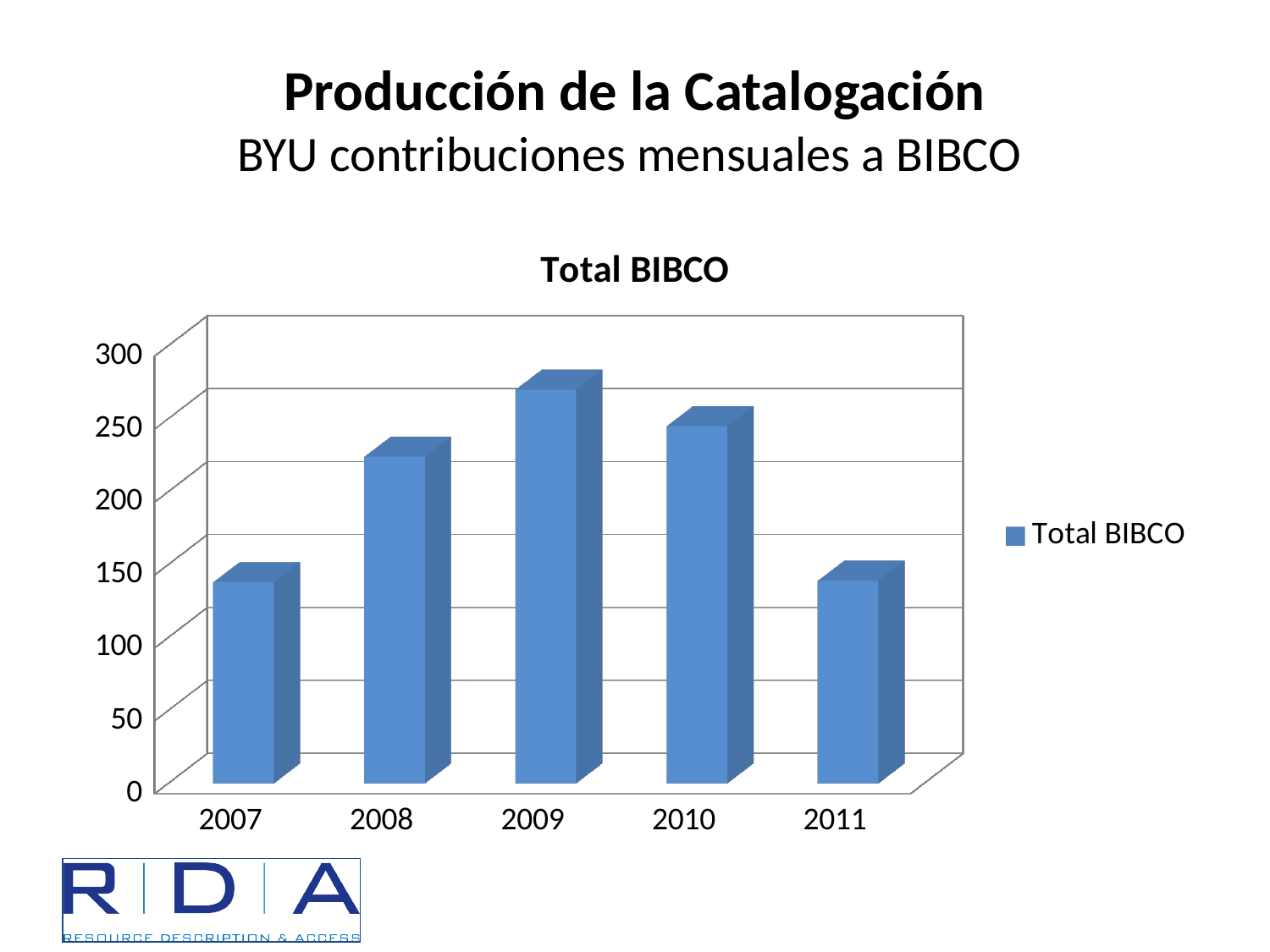
How many years are shown on the x axis of the chart? 5 How many series does the legend list? 1 Is the value for 2007 greater or less than 150? less Which year has the highest Total BIBCO value? 2009 What is the title of the chart? Total BIBCO Is the value for 2011 greater or less than 150? less Do the values rise or fall from 2007 to 2009? rise Is the value for 2008 greater or less than 200? greater What kind of chart is shown on the slide? Bar chart Which year has the larger value, 2010 or 2011? 2010 Which year has the larger value, 2009 or 2008? 2009